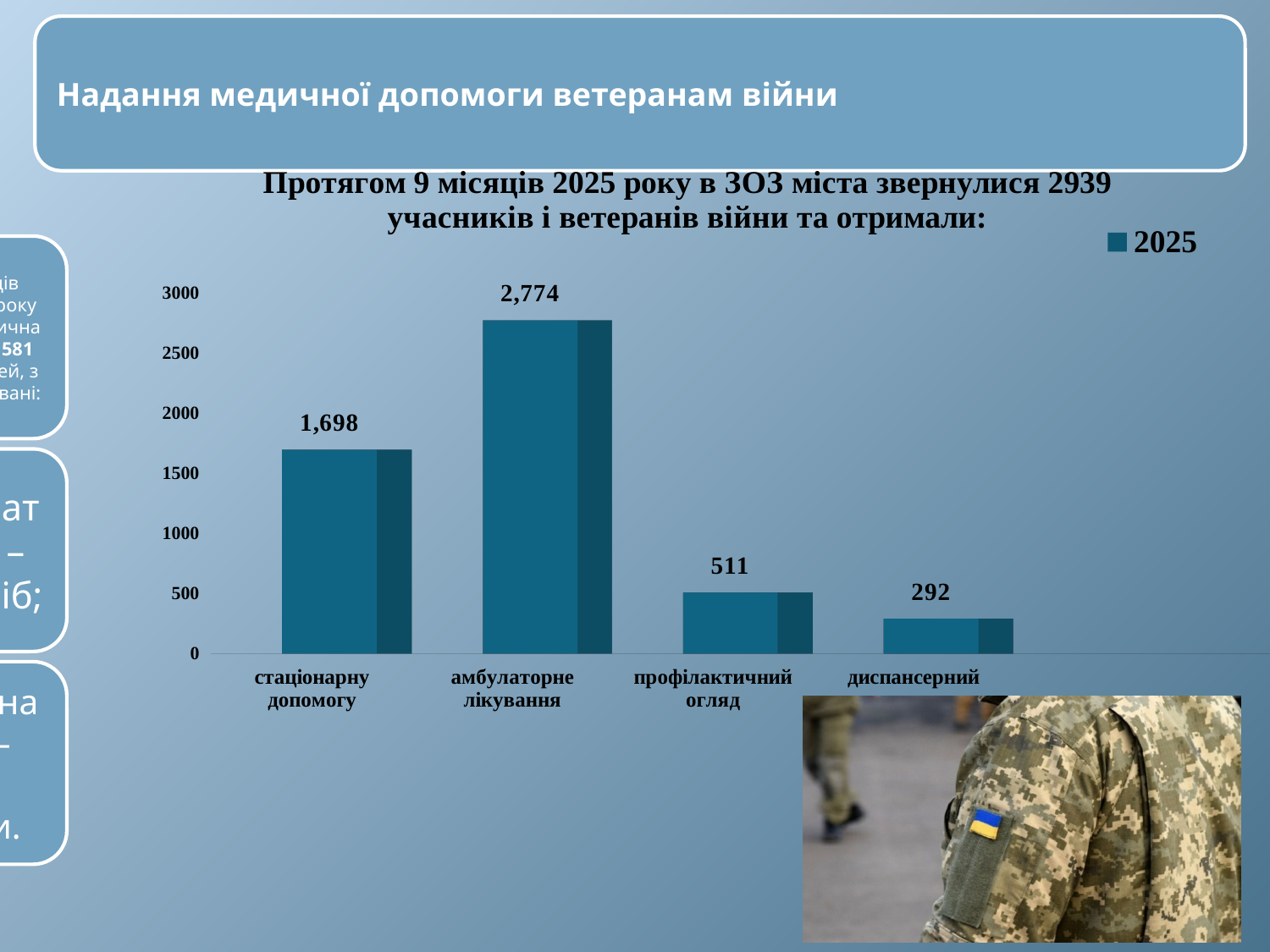
Which category has the lowest value? диспансерний What value is shown for "стаціонарну допомогу"? 1,698 What value is shown for "диспансерний"? 292 What kind of chart is shown on the slide? bar chart How many categories are shown on the x axis? 4 What value is shown for "амбулаторне лікування"? 2,774 What series name does the legend show? 2025 What is the difference between the values for "амбулаторне лікування" and "стаціонарну допомогу"? 1,076 What is the difference between the values for "профілактичний огляд" and "диспансерний"? 219 Which is larger: the value for "стаціонарну допомогу" or the value for "профілактичний огляд"? стаціонарну допомогу Which category has the highest value? амбулаторне лікування What value is shown for "профілактичний огляд"? 511